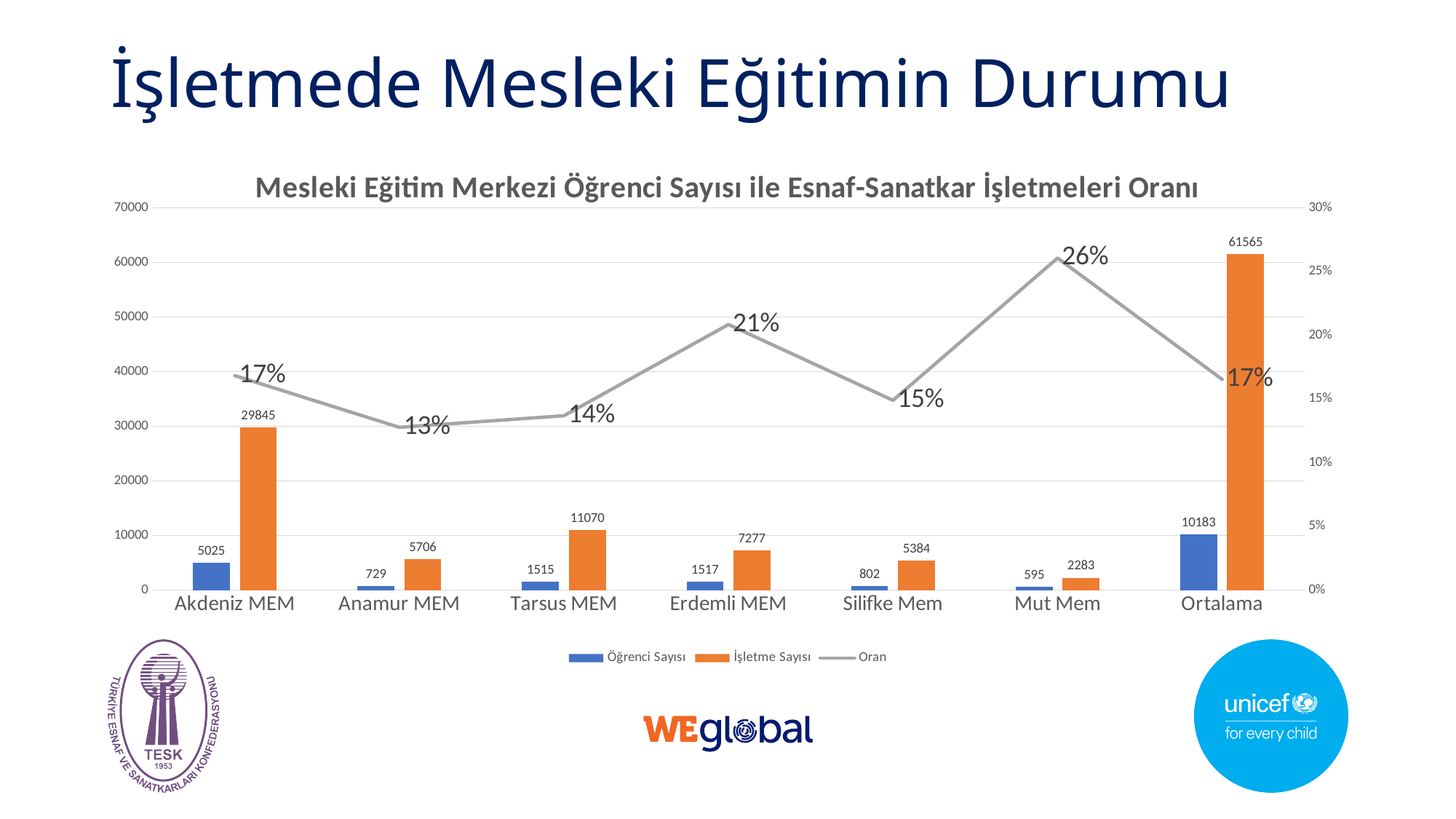
What is the title of the chart? Mesleki Eğitim Merkezi Öğrenci Sayısı ile Esnaf-Sanatkar İşletmeleri Oranı Which category has the highest Oran value? Mut Mem How many series does the legend list? 3 Which is larger, the Öğrenci Sayısı for Silifke Mem or for Mut Mem? Silifke Mem What is the İşletme Sayısı value for Akdeniz MEM? 29845 How many categories are shown on the x axis? 7 What is the difference between the İşletme Sayısı values for Tarsus MEM and Erdemli MEM? 3793 What kind of chart is this? Combined bar and line chart Which category has the lowest İşletme Sayısı value? Mut Mem What is the Öğrenci Sayısı value for Tarsus MEM? 1515 What is the Oran value for Mut Mem? 26% Which category has the lowest Oran value? Anamur MEM